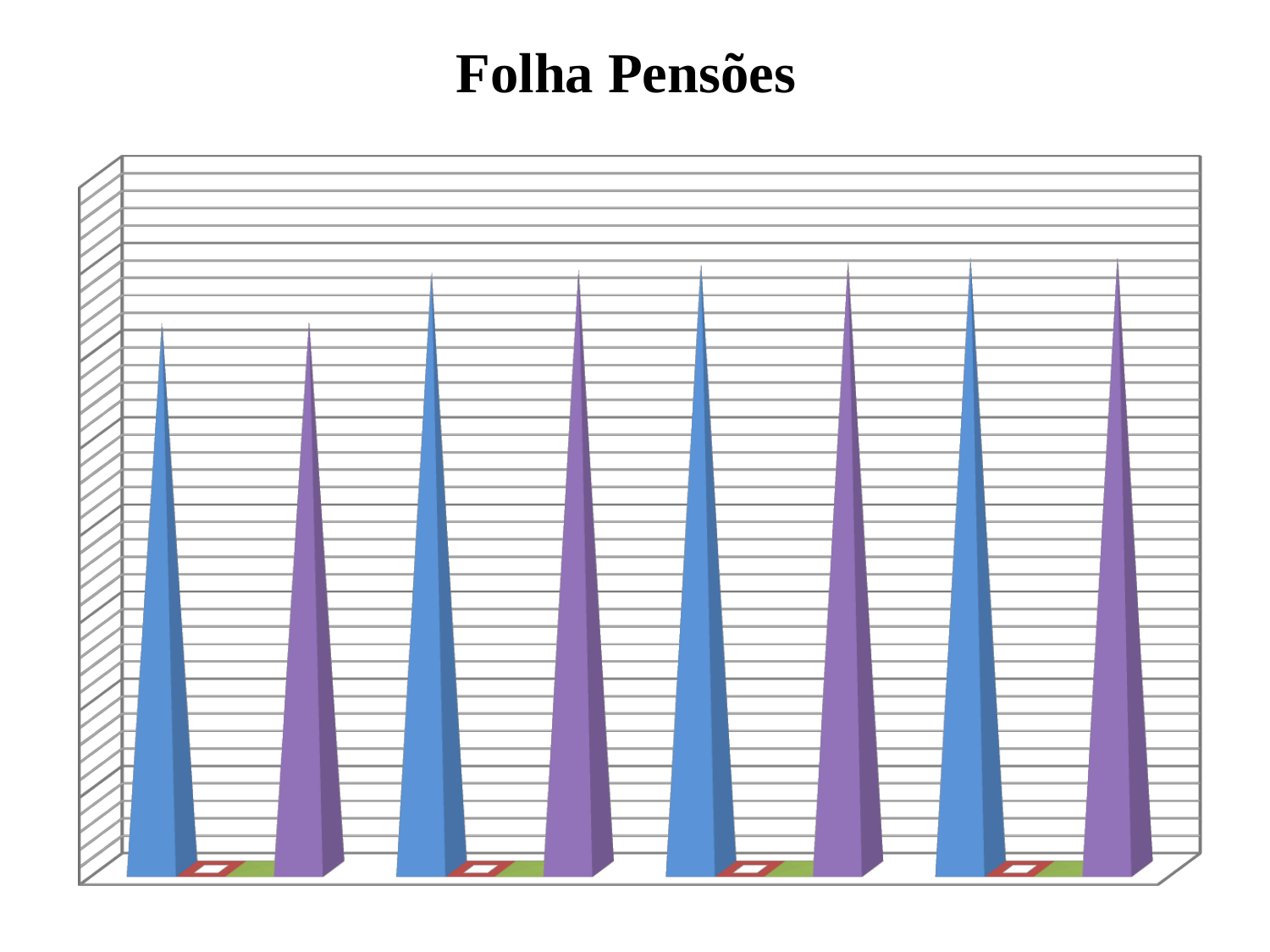
What is the title of the chart? Folha Pensões Which group has the shortest purple bar, the leftmost or the rightmost? leftmost How many differently coloured series are plotted in each group? 4 What kind of chart is shown on the slide? bar chart Which group has the tallest blue bar, the leftmost or the rightmost? rightmost Which series are the shortest in every group, the red and green ones or the blue and purple ones? the red and green ones Which is taller, the blue bar in the first group or the blue bar in the fourth group? the blue bar in the fourth group How many groups of bars are plotted along the x axis? 4 Do the purple bars rise or fall from left to right along the x axis? rise Do the blue bars rise or fall from left to right along the x axis? rise Which is taller, the purple bar in the first group or the purple bar in the second group? the purple bar in the second group